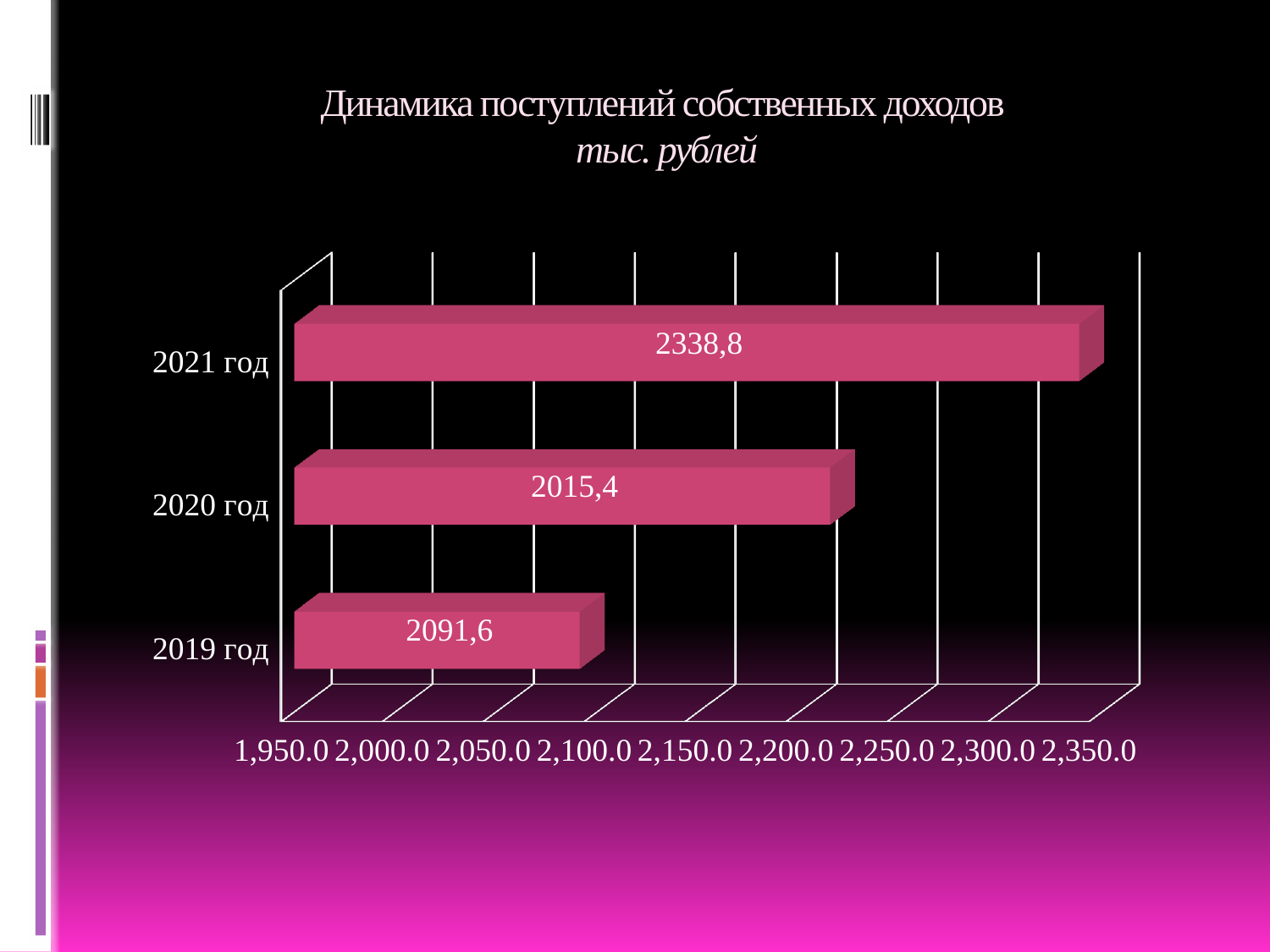
What is the value for 2020 год? 2015,4 What is the value for 2019 год? 2091,6 Is the value for 2021 год greater or less than 2,300.0? greater What kind of chart is shown on the slide? bar chart Is the value for 2019 год greater or less than 2,150.0? less What is the difference between the values for 2021 год and 2019 год? 247,2 Which year has the highest value? 2021 год What is the value for 2021 год? 2338,8 Which is larger, the value for 2021 год or the value for 2020 год? 2021 год In what units are the values on the chart expressed, according to the title? тыс. рублей How many years are shown in the chart? 3